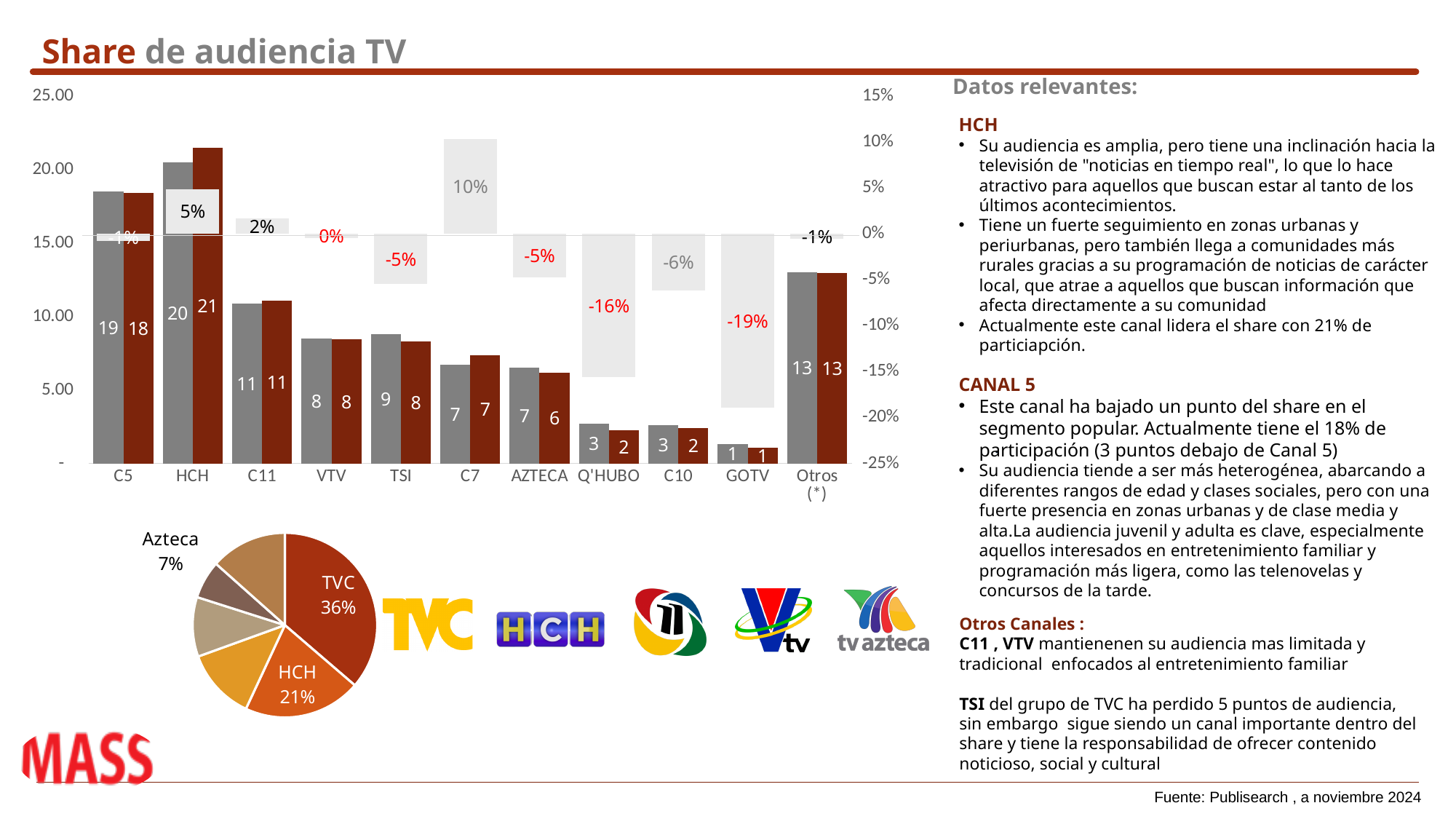
In the top bar chart, how many channel categories are shown on the x axis? 11 In the pie chart at the bottom, what share does Azteca have? 7% In the top bar chart, what percentage change label is shown for C7? 10% In the top bar chart, which has the larger gray bar value, TSI or VTV? TSI In the top bar chart, what is the difference between the dark red bar values for HCH and C5? 3 In the top bar chart, what is the value of the dark red bar for HCH? 21 In the top bar chart, what percentage change label is shown for GOTV? -19% In the top bar chart, what is the value of the gray bar for C5? 19 In the pie chart at the bottom, what share does TVC have? 36% In the top bar chart, which category has the highest dark red bar? HCH What kind of chart is the top chart on the slide? bar chart In the top bar chart, which category has the lowest dark red bar? GOTV